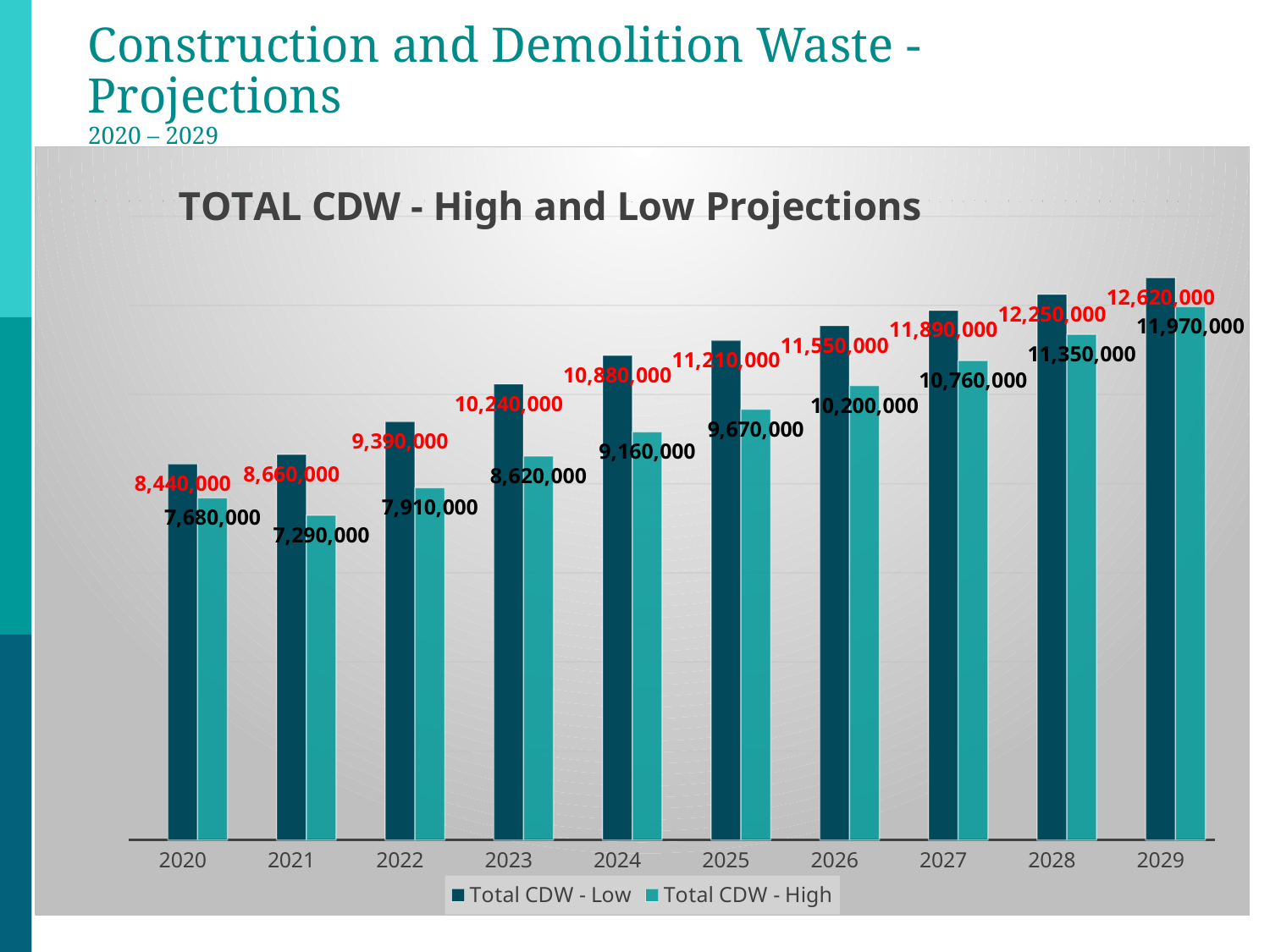
What type of chart is shown on the slide? Bar chart How many years are shown along the x axis of the chart? 10 What is the value shown in the black data label for 2025? 9,670,000 Do the red-labelled values rise or fall from 2020 to 2029? Rise What is the value shown in the black data label for 2021? 7,290,000 How many series does the legend of the chart list? 2 What is the difference between the red-labelled value and the black-labelled value for 2020? 760,000 What is the value shown in the red data label for 2020? 8,440,000 What are the two entries in the chart's legend? Total CDW - Low and Total CDW - High What is the difference between the red-labelled value and the black-labelled value for 2029? 650,000 What is the value shown in the red data label for 2029? 12,620,000 Which year has the lowest black-labelled value? 2021